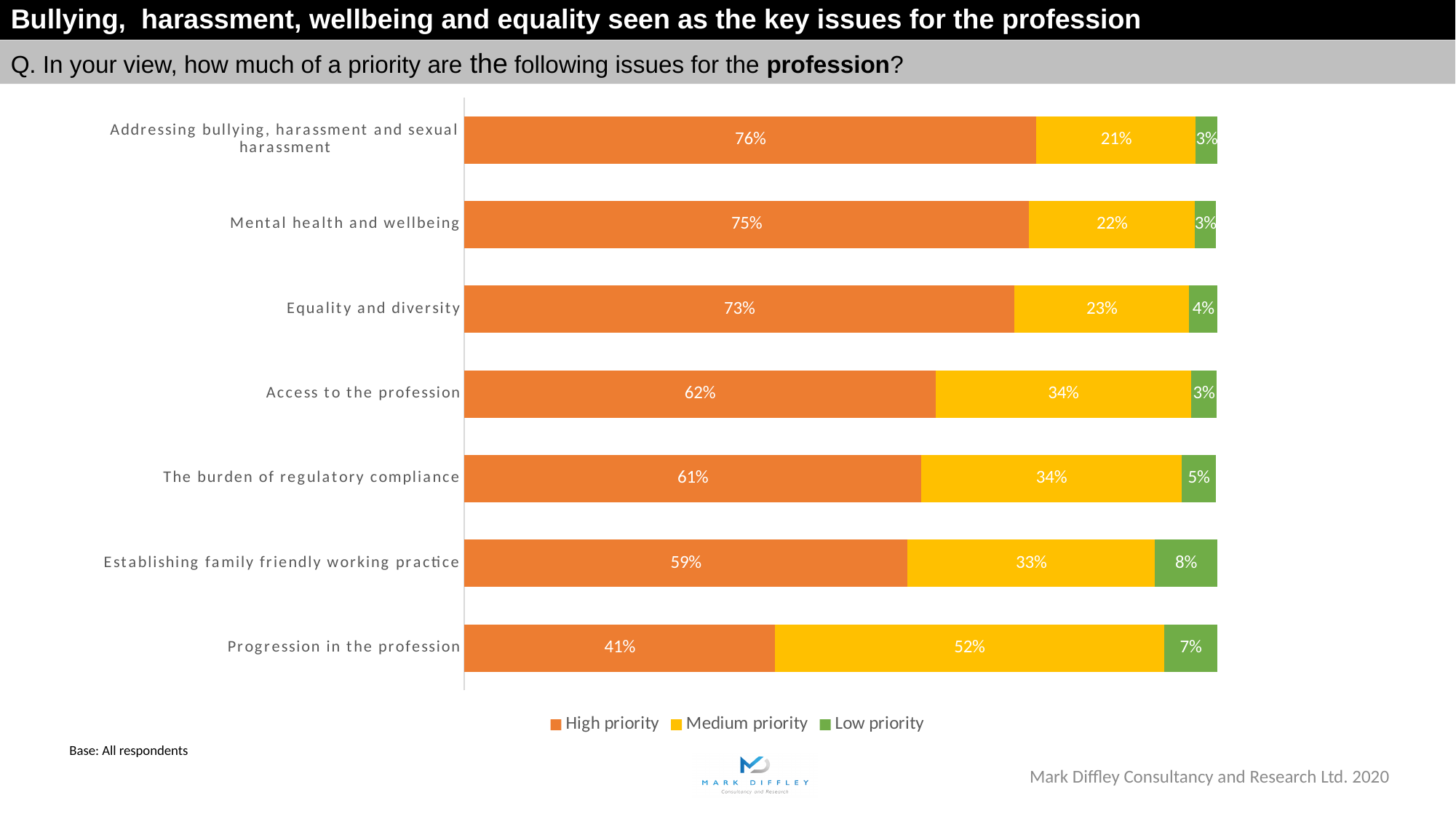
Which has a larger 'Medium priority' value: 'Equality and diversity' or 'Access to the profession'? Access to the profession What is the difference between the 'High priority' values for 'Mental health and wellbeing' and 'Progression in the profession'? 34 percentage points What is the 'Medium priority' value for 'Progression in the profession'? 52% Which issue has the lowest 'High priority' percentage? Progression in the profession What is the 'Low priority' value for 'Establishing family friendly working practice'? 8% Which colour represents 'Low priority' in the chart? Green How many issues are shown in the chart? 7 What percentage of respondents rated 'Addressing bullying, harassment and sexual harassment' as a high priority? 76% What is the total of the three segments for 'The burden of regulatory compliance'? 100% Which issue has the highest 'High priority' percentage? Addressing bullying, harassment and sexual harassment What kind of chart is shown on the slide? Stacked bar chart How many series does the legend list? 3